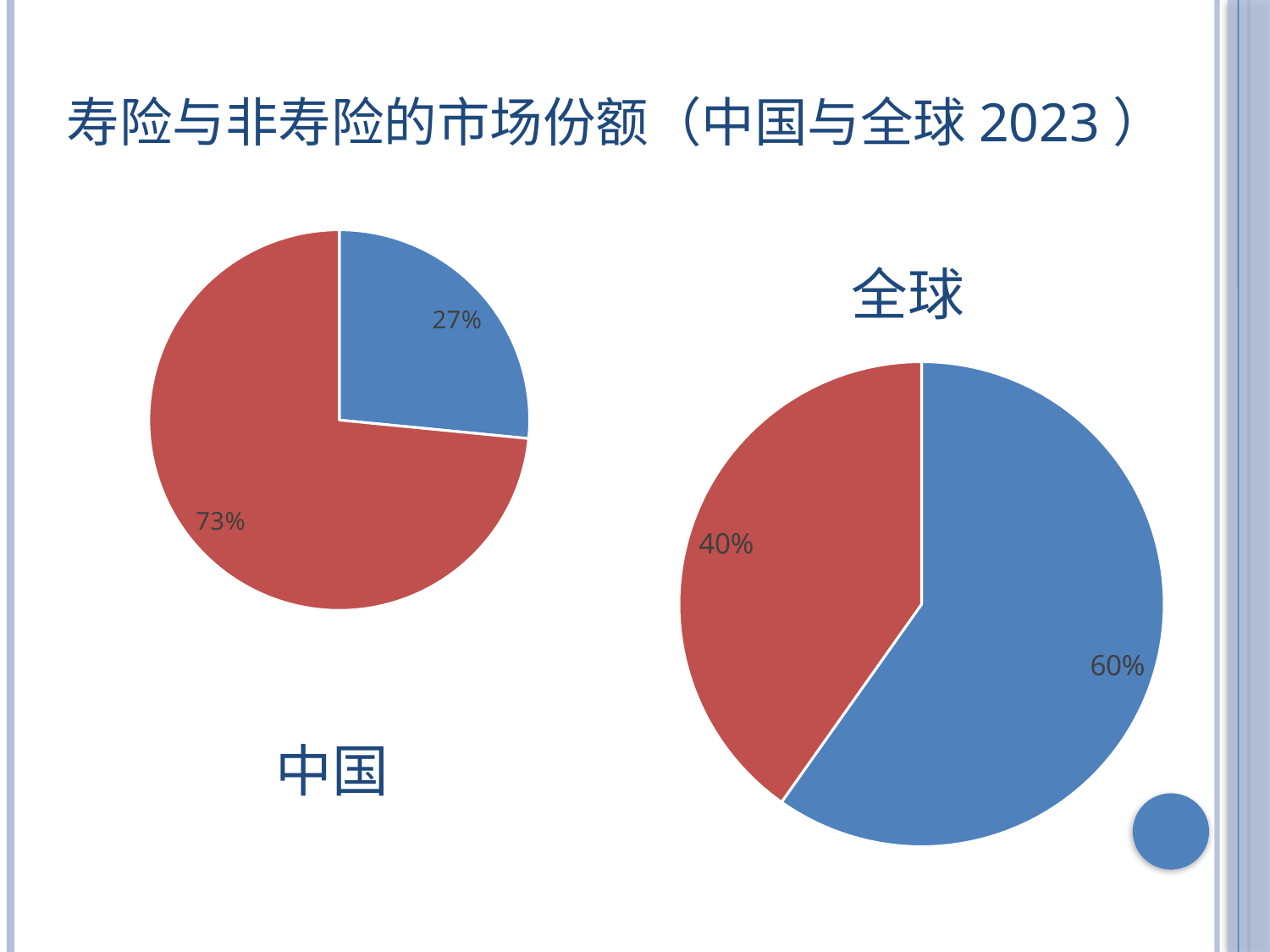
In the 全球 pie chart, what is the difference between the blue slice and the red slice? 20% Is the blue slice larger in the 中国 pie chart or in the 全球 pie chart? 全球 How many pie charts are shown on the slide? 2 In the 全球 pie chart, which colour slice is the smallest? red In the 全球 pie chart, what share does the red slice have? 40% In the 中国 pie chart, what share does the red slice have? 73% In the 全球 pie chart, what share does the blue slice have? 60% How many slices does the 全球 pie chart have? 2 In the 中国 pie chart, which colour slice is the largest? red In the 中国 pie chart, what is the difference between the red slice and the blue slice? 46% What kind of chart is used for the 中国 chart? pie chart In the 中国 pie chart, what share does the blue slice have? 27%